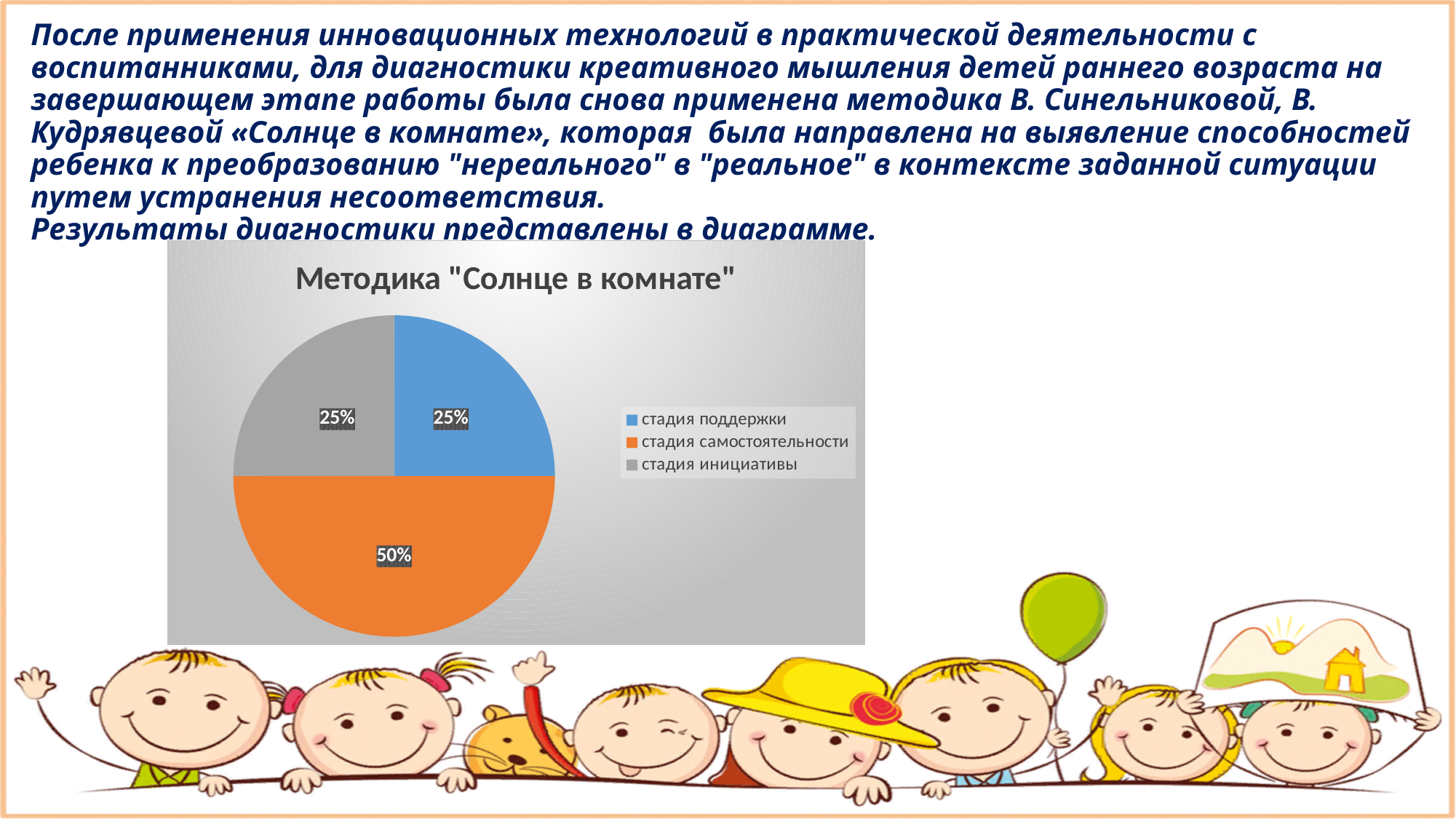
How many slices does the pie chart have? 3 What percentage is shown for стадия поддержки? 25% What colour is the slice for стадия самостоятельности? orange What percentage is shown for стадия самостоятельности? 50% What is the title of the chart? Методика "Солнце в комнате" What share of the pie do стадия поддержки and стадия инициативы make up together? 50% Which is larger: the slice for стадия самостоятельности or the slice for стадия инициативы? стадия самостоятельности Which category has the largest slice of the pie? стадия самостоятельности How many entries does the legend list? 3 What kind of chart is shown on the slide? pie chart What percentage is shown for стадия инициативы? 25% What is the difference between the share for стадия самостоятельности and the share for стадия поддержки? 25%